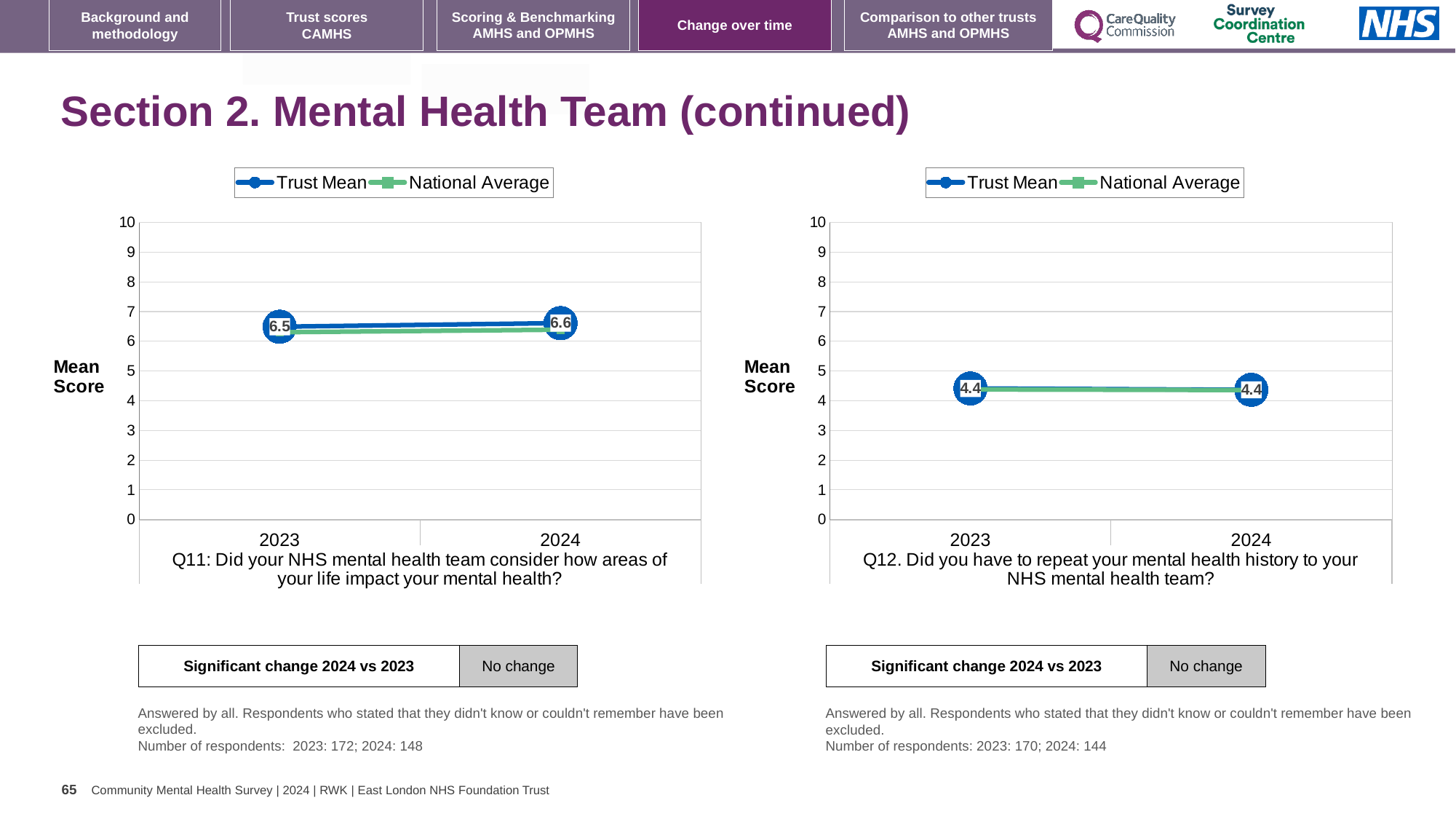
In the right chart (Q12), does the Trust Mean rise, fall or stay the same from 2023 to 2024? stays the same In the left chart (Q11), what is the difference between the Trust Mean in 2024 and in 2023? 0.1 In the right chart (Q12), what is the Trust Mean for 2024? 4.4 In the left chart (Q11), what is the Trust Mean for 2023? 6.5 In the right chart (Q12), is the National Average for 2024 greater or less than 5? less How many series does the legend of the left chart (Q11) list? 2 What type of chart is the right chart (Q12)? line chart In the left chart (Q11), what is the Trust Mean for 2024? 6.6 What does the 'Significant change 2024 vs 2023' box below the left chart (Q11) say? No change In the left chart (Q11), is the National Average for 2023 greater or less than 6? greater In the left chart (Q11), which year has the higher Trust Mean, 2023 or 2024? 2024 How many years are shown on the x axis of the right chart (Q12)? 2